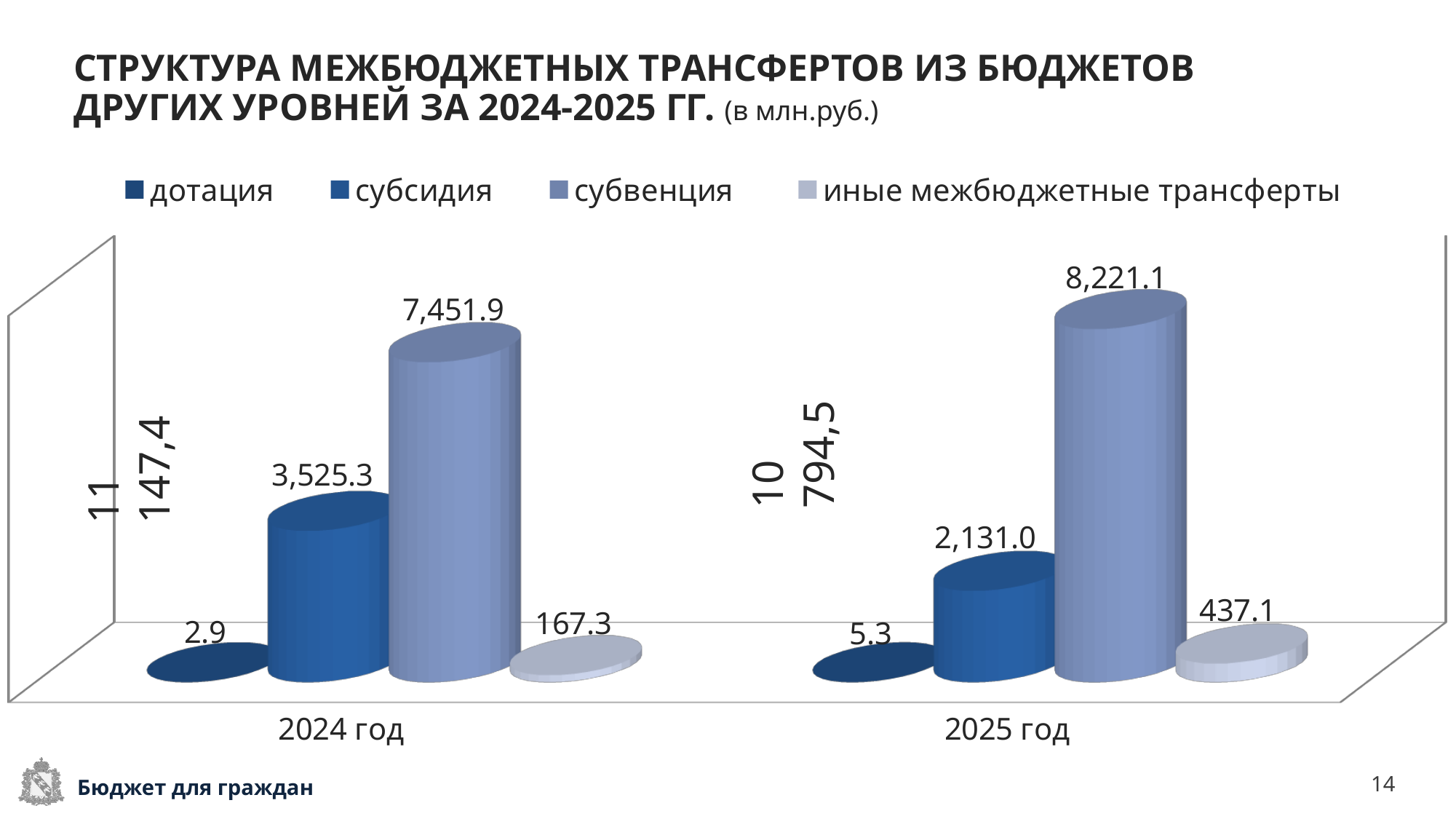
What is the value for субвенция in 2024 год? 7,451.9 What kind of chart is shown on the slide? bar chart What is the value for субсидия in 2025 год? 2,131.0 What is the value for иные межбюджетные трансферты in 2025 год? 437.1 What is the difference between the субвенция values for 2025 год and 2024 год? 769.2 Which series has the lowest value in 2024 год? дотация Which is larger: субсидия in 2024 год or субсидия in 2025 год? субсидия in 2024 год How many series does the legend list? 4 How many year categories are shown on the x axis? 2 What is the value for дотация in 2024 год? 2.9 Does the value for иные межбюджетные трансферты rise or fall from 2024 год to 2025 год? rise Which series has the highest value in 2025 год? субвенция